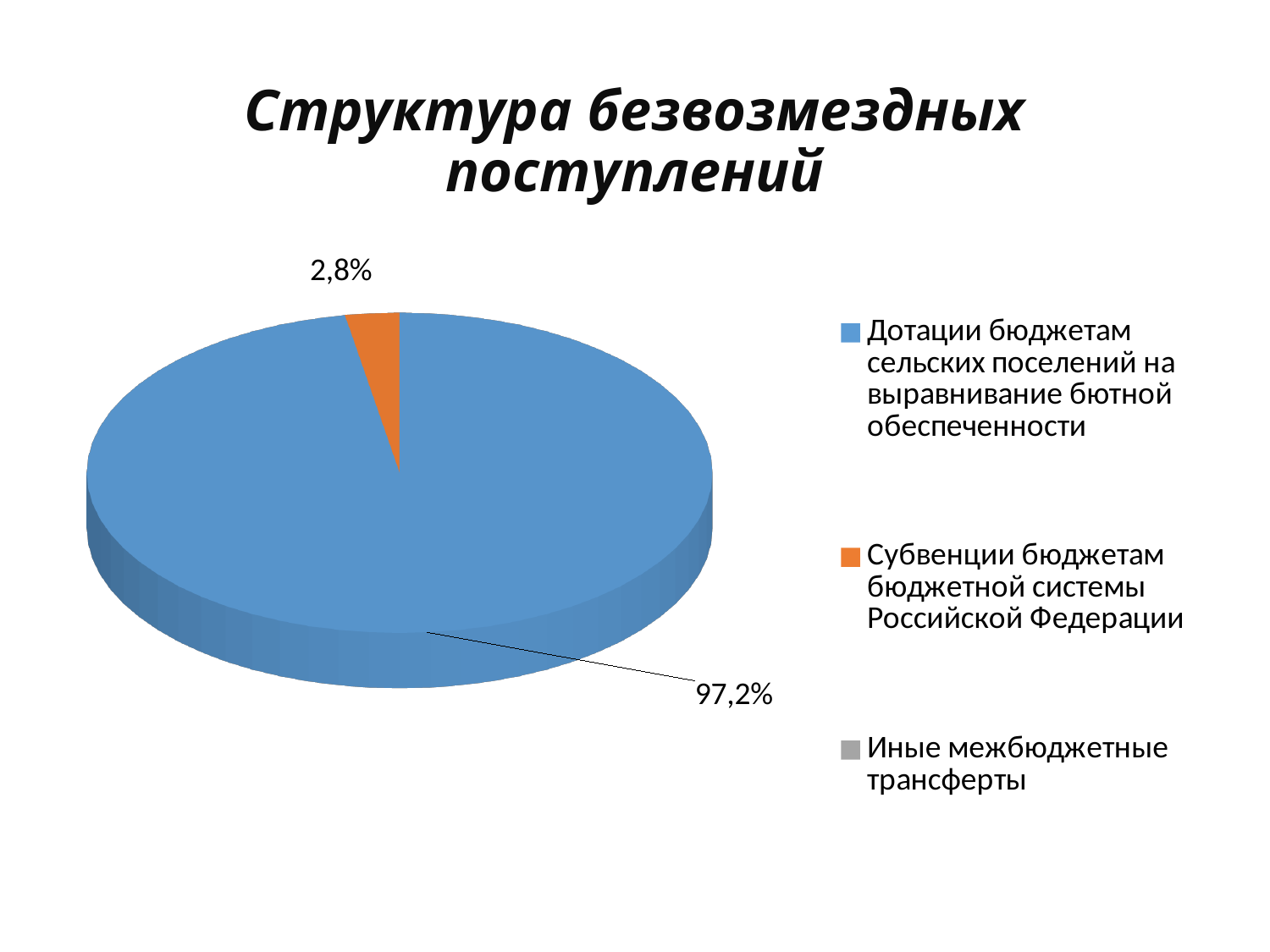
Which of the two labelled slices is the smaller one? Субвенции бюджетам бюджетной системы Российской Федерации What is the combined share of the two labelled slices? 100% What kind of chart is shown on the slide? Pie chart What colour is the slice for Субвенции бюджетам бюджетной системы Российской Федерации? Orange How many entries does the legend list? 3 What is the difference between the 97,2% slice and the 2,8% slice? 94,4% How many slices with printed percentage labels are visible in the pie? 2 What share of the pie is labelled for Дотации бюджетам сельских поселений на выравнивание бютной обеспеченности? 97,2% Which category has the largest slice of the pie? Дотации бюджетам сельских поселений на выравнивание бютной обеспеченности What is the title of the chart? Структура безвозмездных поступлений Which is larger: the share for Дотации or the share for Субвенции? Дотации What share of the pie is labelled for Субвенции бюджетам бюджетной системы Российской Федерации? 2,8%